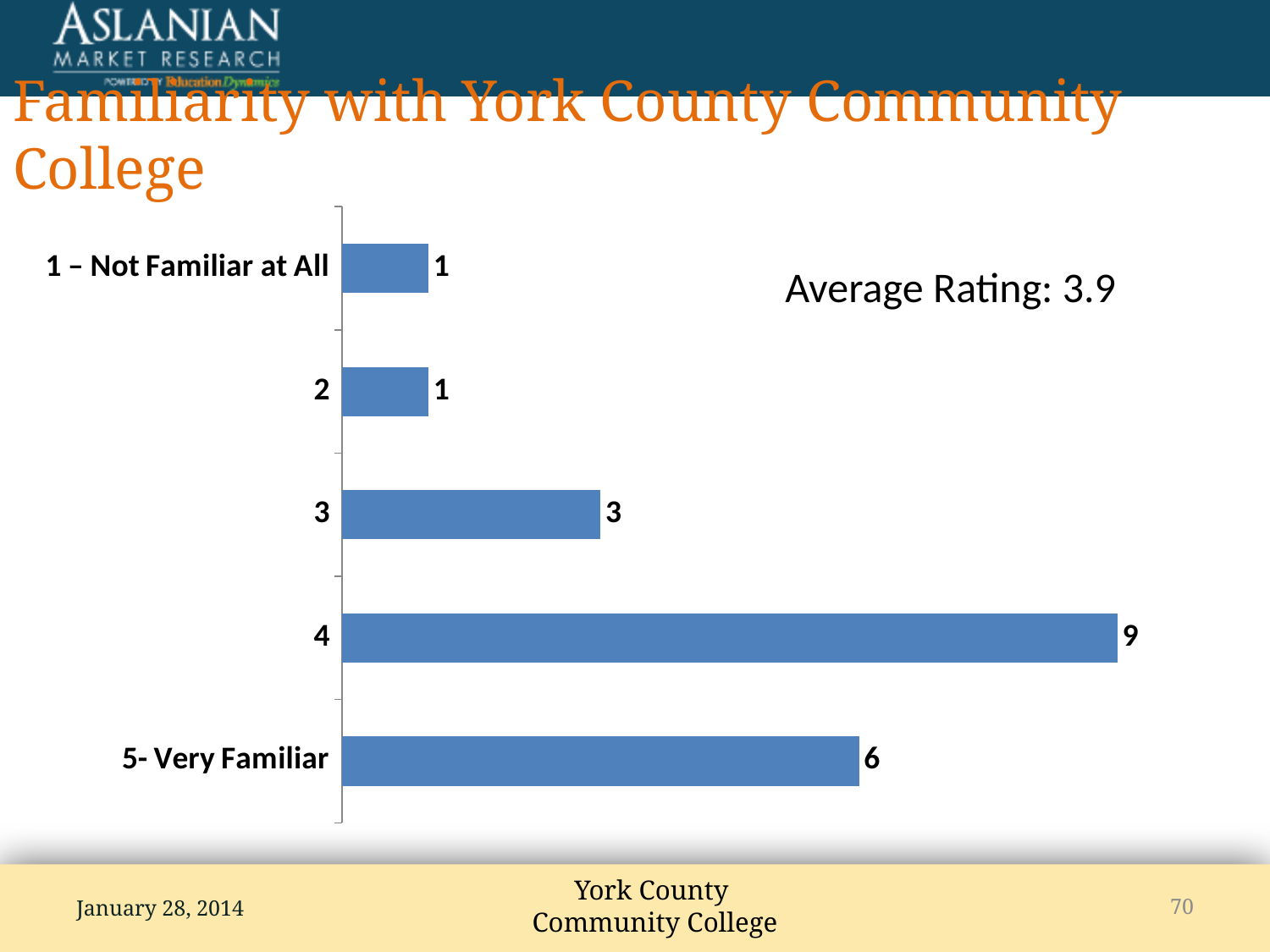
What is the value for '1 - Not Familiar at All'? 1 What is the difference between the values for rating '4' and '5- Very Familiar'? 3 What is the value for '5- Very Familiar'? 6 What is the value for the '3' rating category? 3 What average rating is stated on the slide? 3.9 What is the total of all the values shown in the chart? 20 Which is larger, the value for rating '3' or the value for rating '2'? 3 What kind of chart is shown on the slide? Bar chart What is the title of the slide? Familiarity with York County Community College Which category has the highest value? 4 How many categories are shown in the chart? 5 What is the value for the '4' rating category? 9